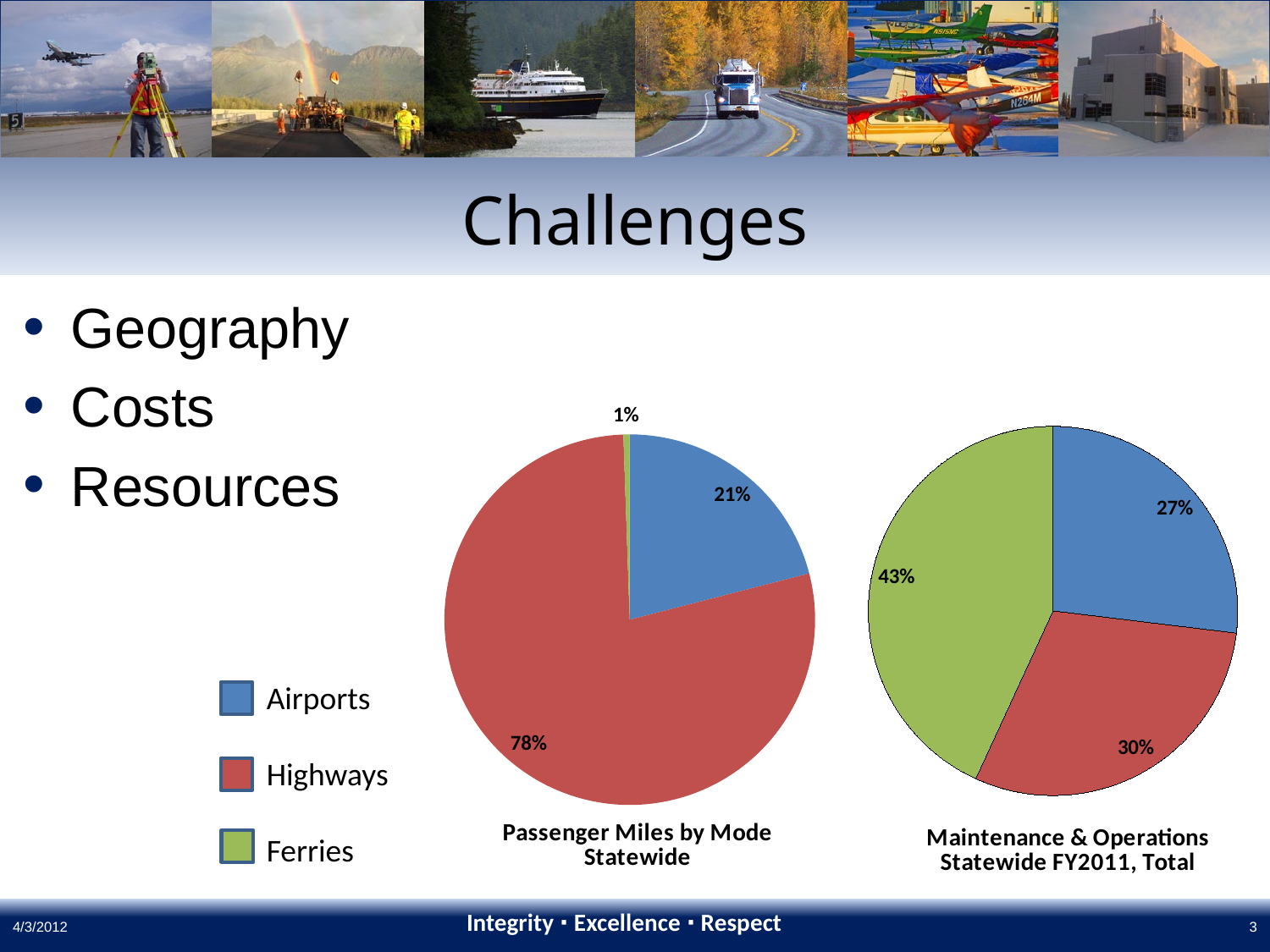
In the Passenger Miles by Mode Statewide chart, which mode has the smallest share? Ferries In the Passenger Miles by Mode Statewide chart, what share do Ferries have? 1% In the Maintenance & Operations Statewide FY2011, Total chart, which mode has the largest share? Ferries How many modes does the legend list for the charts? 3 What kind of chart is the Passenger Miles by Mode Statewide chart? Pie chart In the Passenger Miles by Mode Statewide chart, what share do Airports have? 21% In the Maintenance & Operations Statewide FY2011, Total chart, what share do Highways have? 30% In the Passenger Miles by Mode Statewide chart, what share do Highways have? 78% In the Maintenance & Operations Statewide FY2011, Total chart, which mode has the smallest share? Airports In the Maintenance & Operations Statewide FY2011, Total chart, which is larger, the Ferries share or the Airports share? Ferries In the Maintenance & Operations Statewide FY2011, Total chart, what share do Ferries have? 43% In the Passenger Miles by Mode Statewide chart, what is the difference between the Highways share and the Airports share? 57%